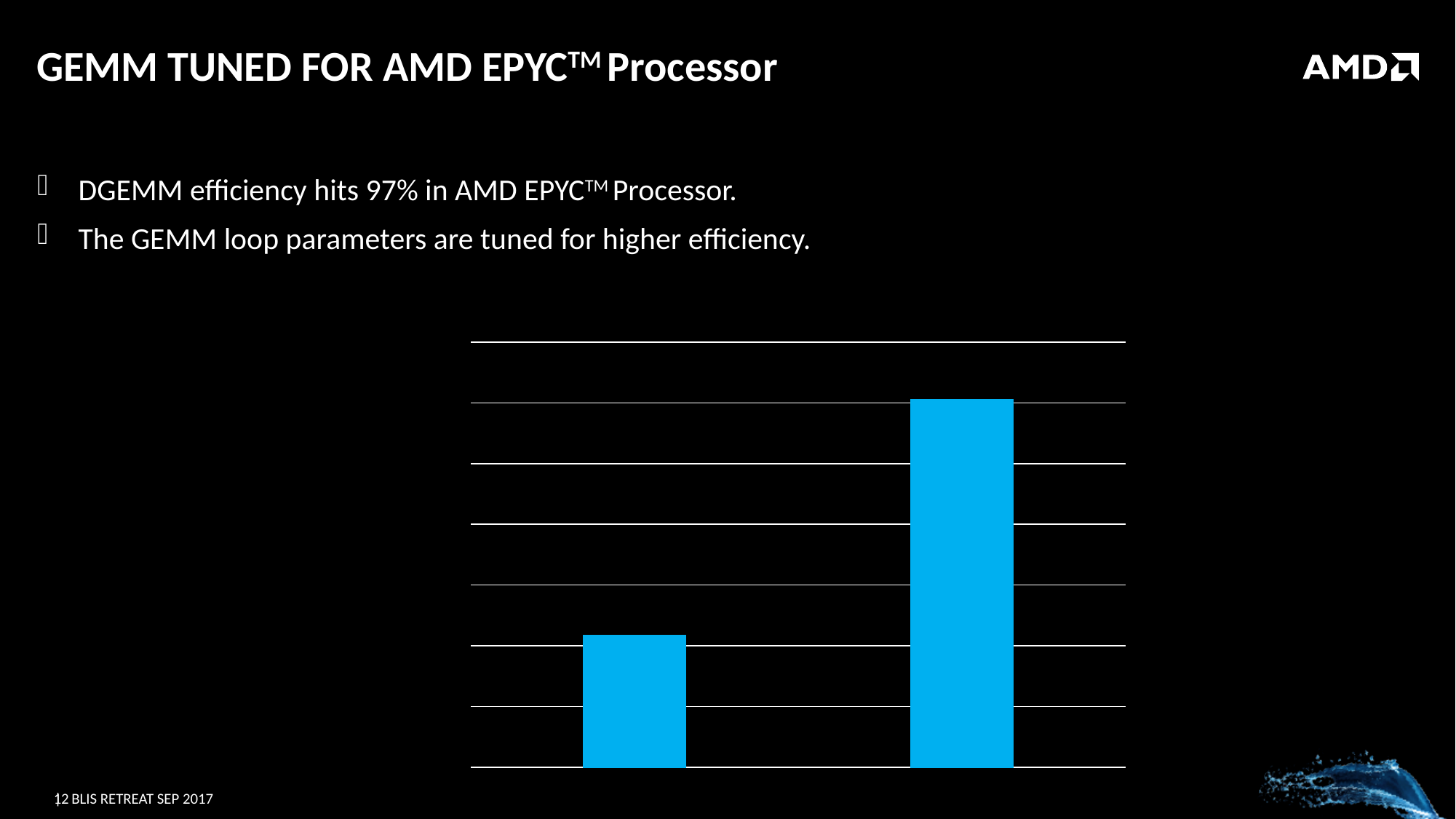
Does the chart display a legend? No What colour are the bars in the chart? blue Which bar in the chart is the shortest? the left bar How many bars are plotted in the chart? 2 Do the bar heights rise or fall from left to right in the chart? rise Which bar is taller in the chart, the left bar or the right bar? the right bar What kind of chart is shown on the slide? bar chart